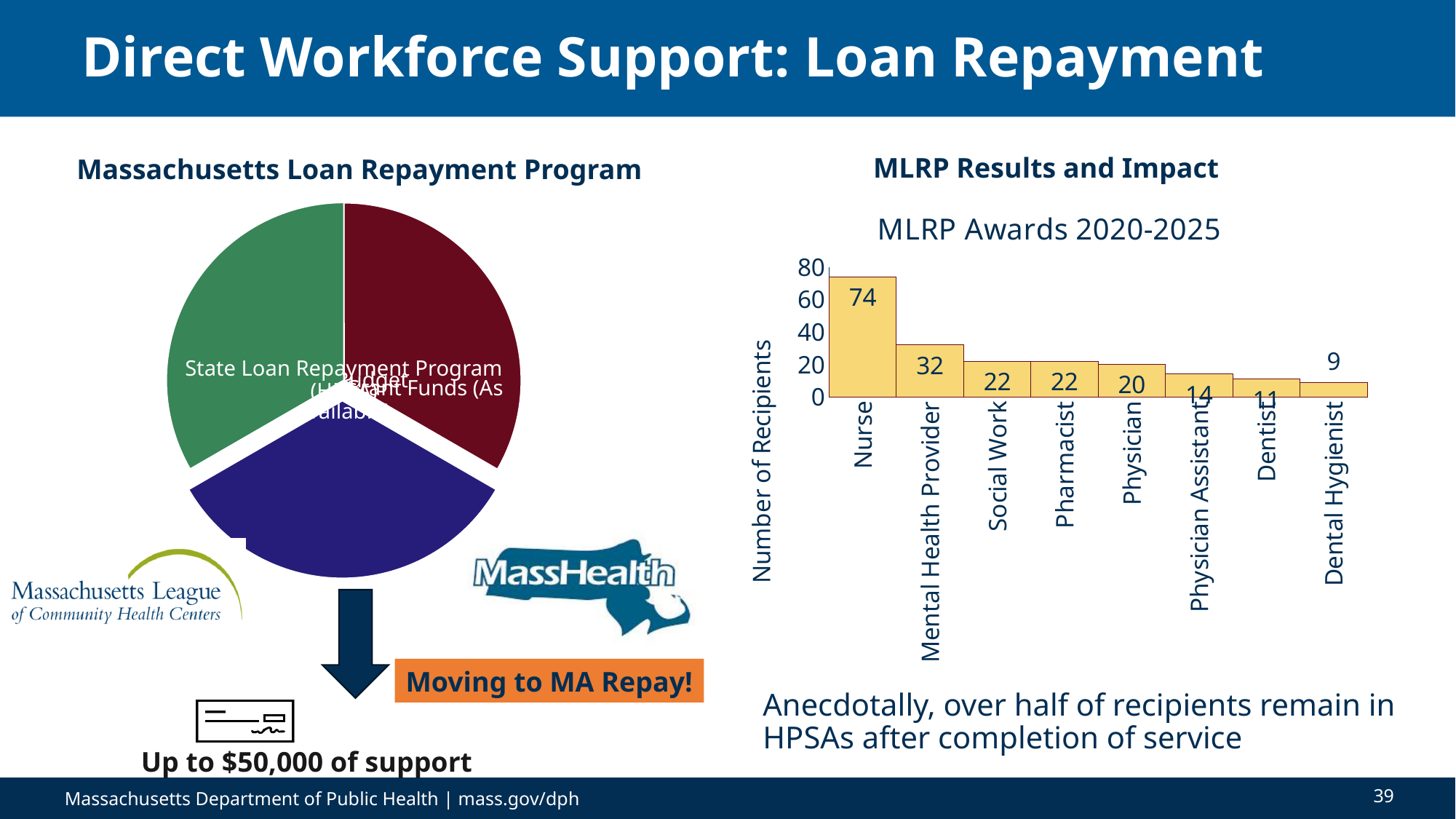
In the MLRP Awards 2020-2025 chart, what is the value for Dental Hygienist? 9 How many categories are shown in the MLRP Awards 2020-2025 chart? 8 In the MLRP Awards 2020-2025 chart, do the values rise or fall from left to right? fall What kind of chart is the MLRP Awards 2020-2025 chart? bar chart What is the y-axis label of the MLRP Awards 2020-2025 chart? Number of Recipients In the MLRP Awards 2020-2025 chart, what is the difference between the Nurse and Mental Health Provider values? 42 In the MLRP Awards 2020-2025 chart, which category has the lowest number of recipients? Dental Hygienist In the MLRP Awards 2020-2025 chart, which is larger, Physician or Dentist? Physician In the MLRP Awards 2020-2025 chart, which category has the highest number of recipients? Nurse In the MLRP Awards 2020-2025 chart, what is the value for Mental Health Provider? 32 In the MLRP Awards 2020-2025 chart, how many recipients were nurses? 74 In the MLRP Awards 2020-2025 chart, is the value for Physician Assistant greater or less than 20? less